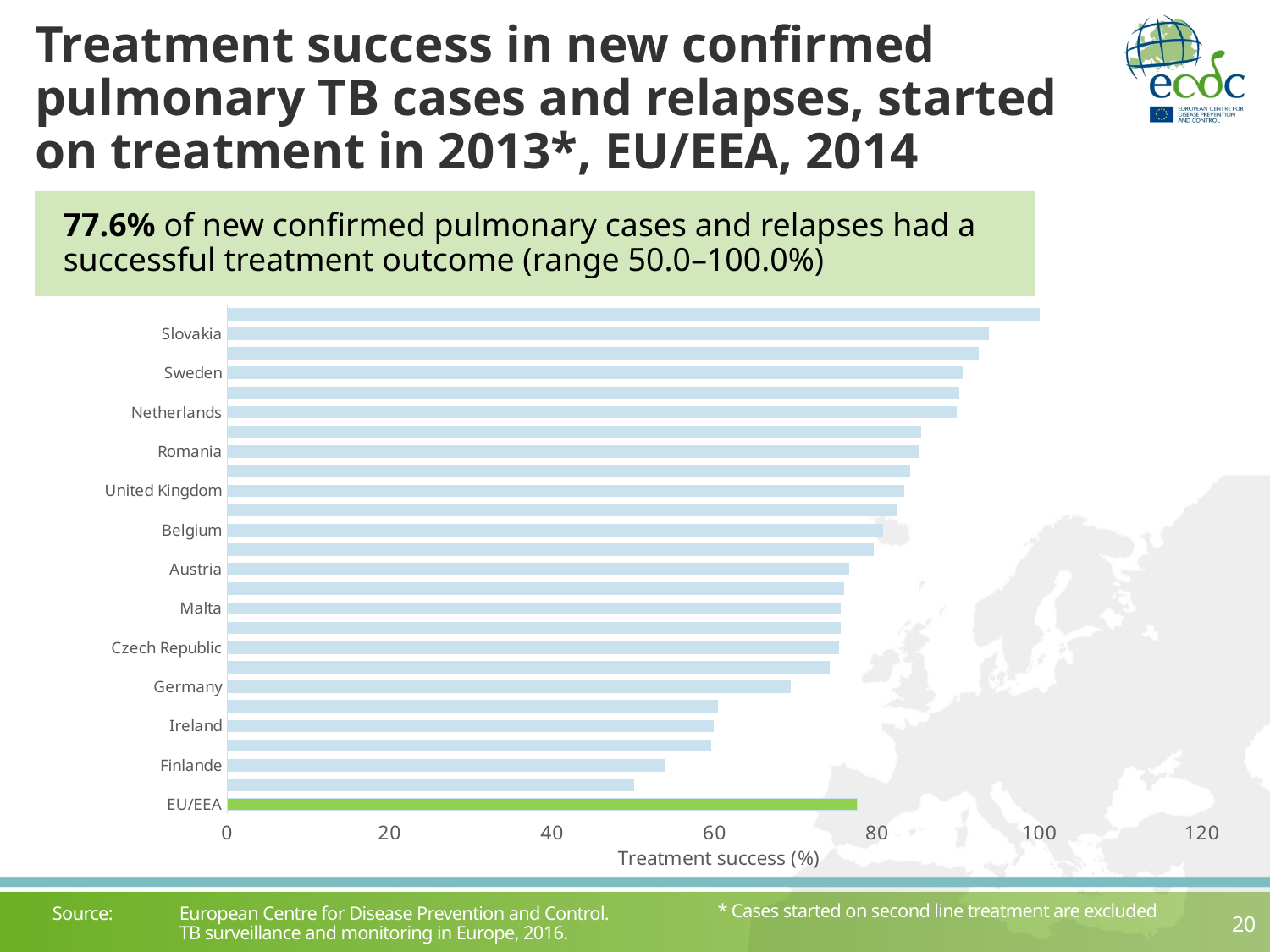
Which has the larger treatment success value, Ireland or Romania? Romania What type of chart is shown on the slide? bar chart Is the value for Austria greater or less than 80? less What is the treatment success value for EU/EEA? 77.6% Which has the larger treatment success value, Slovakia or Germany? Slovakia Is the value for Netherlands greater or less than 80? greater Is the value for Germany greater or less than 60? greater What colour is the EU/EEA bar? green Among the labelled countries, which has the lowest treatment success? Finlande What is the title of the horizontal axis? Treatment success (%)